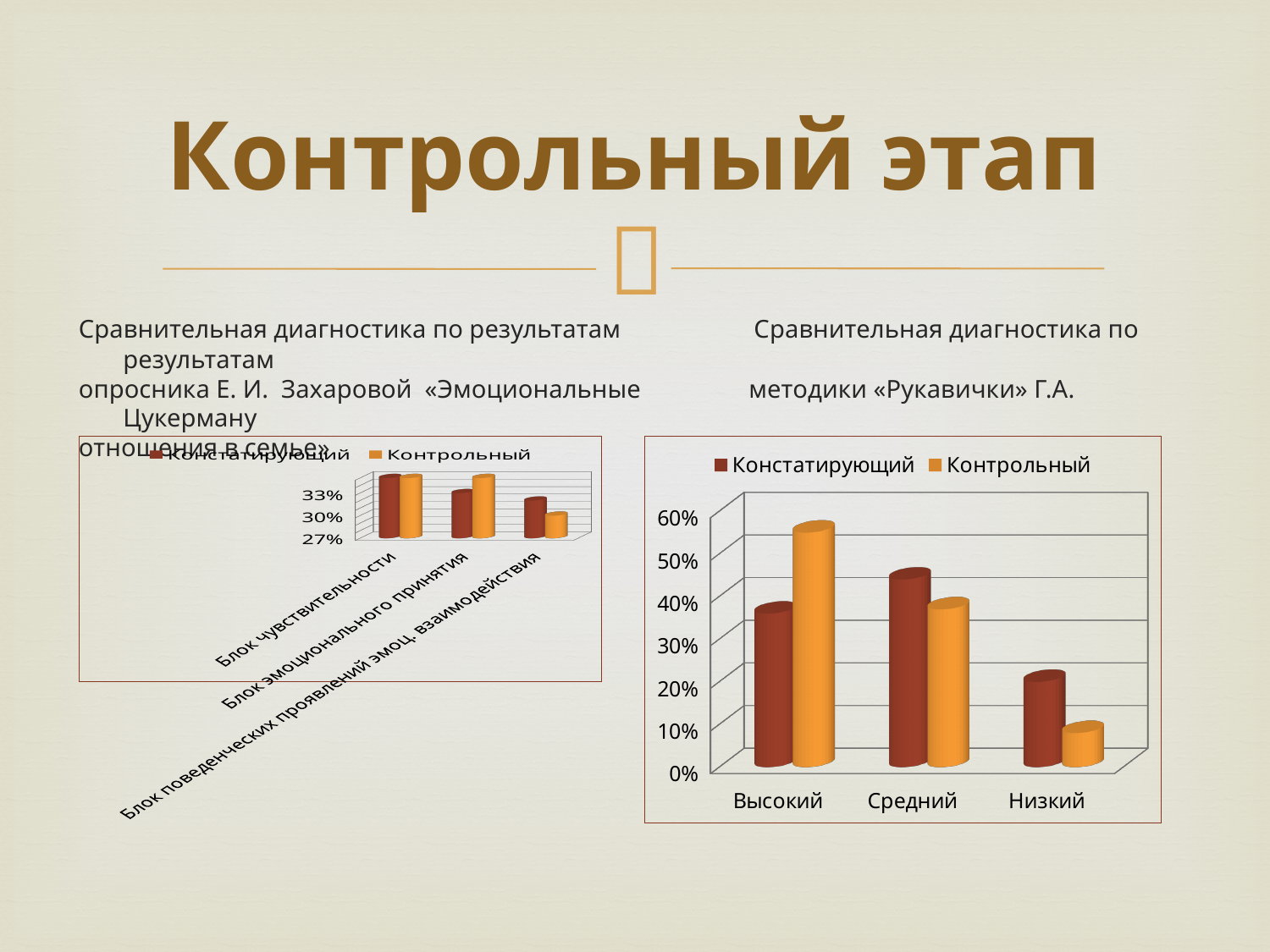
On the right-hand chart, which category has the lowest Контрольный value? Низкий On the right-hand chart, is the Контрольный value for Высокий greater or less than 50%? greater On the left-hand chart, how many categories are shown on the x axis? 3 On the right-hand chart, is the Констатирующий value for Средний greater or less than 40%? greater On the right-hand chart, which category has the highest Контрольный value? Высокий On the right-hand chart, which series has the larger value for Низкий, Констатирующий or Контрольный? Констатирующий What kind of chart is the right-hand chart? Bar chart On the right-hand chart, how many series does the legend list? 2 On the left-hand chart, which series has the larger value for Блок поведенческих проявлений эмоц. взаимодействия, Констатирующий or Контрольный? Констатирующий On the right-hand chart, which series has the larger value for Высокий, Констатирующий or Контрольный? Контрольный On the right-hand chart, how many categories are shown on the x axis? 3 On the right-hand chart, is the Констатирующий value for Низкий greater or less than 30%? less